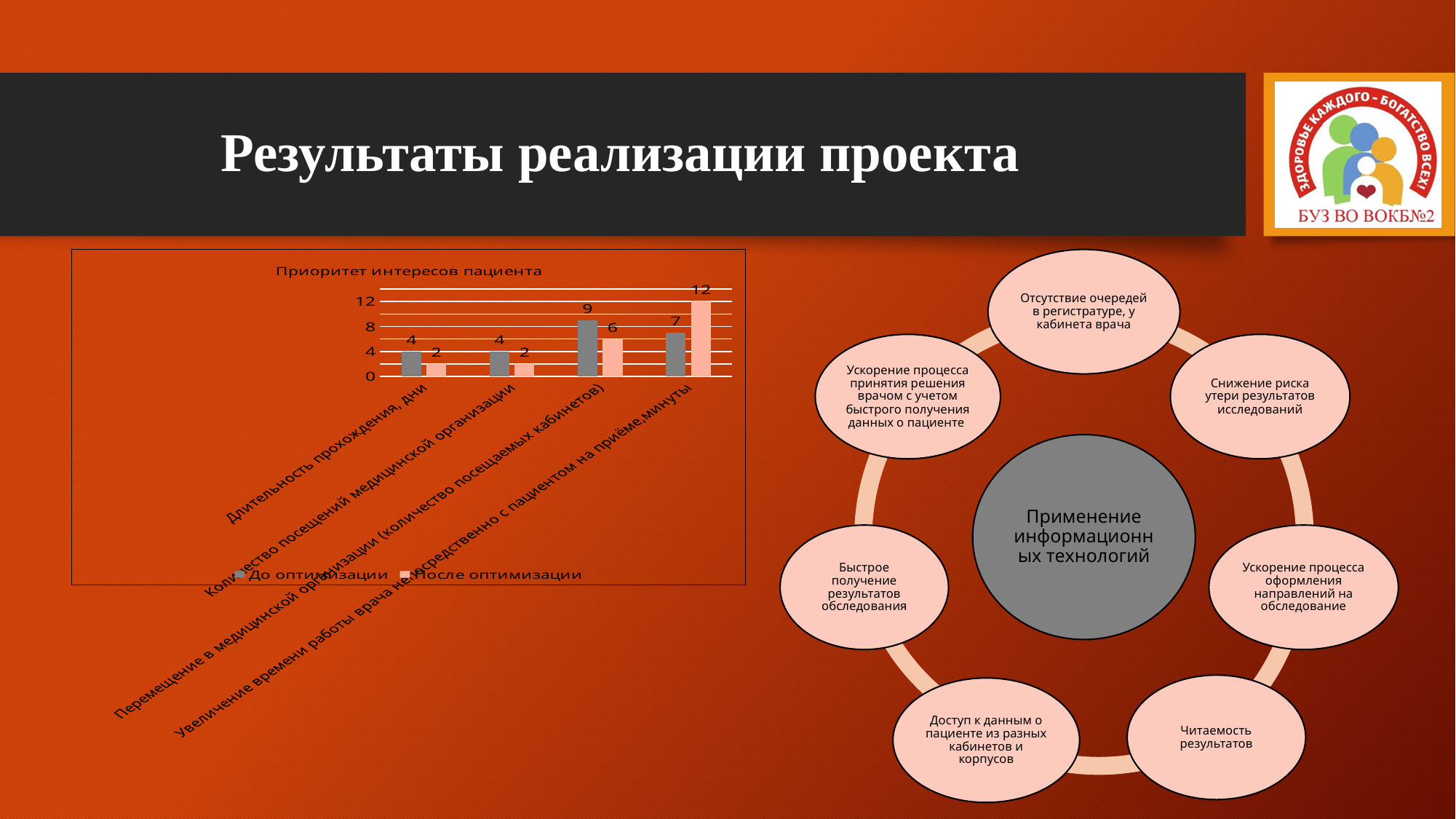
For 'Увеличение времени работы врача непосредственно с пациентом на приёме, минуты', which is larger: 'До оптимизации' or 'После оптимизации'? После оптимизации What is the value of 'После оптимизации' for 'Увеличение времени работы врача непосредственно с пациентом на приёме, минуты'? 12 What kind of chart is shown on the slide? bar chart What is the value of 'До оптимизации' for 'Длительность прохождения, дни'? 4 How many series does the chart legend list? 2 What is the difference between the 'До оптимизации' and 'После оптимизации' values for 'Перемещение в медицинской организации (количество посещаемых кабинетов)'? 3 What is the value of 'До оптимизации' for 'Перемещение в медицинской организации (количество посещаемых кабинетов)'? 9 How many categories are shown on the chart's x axis? 4 What is the title of the chart on the slide? Приоритет интересов пациента Which series is shown in gray in the chart? До оптимизации Which category has the highest 'После оптимизации' value? Увеличение времени работы врача непосредственно с пациентом на приёме, минуты What is the value of 'После оптимизации' for 'Количество посещений медицинской организации'? 2